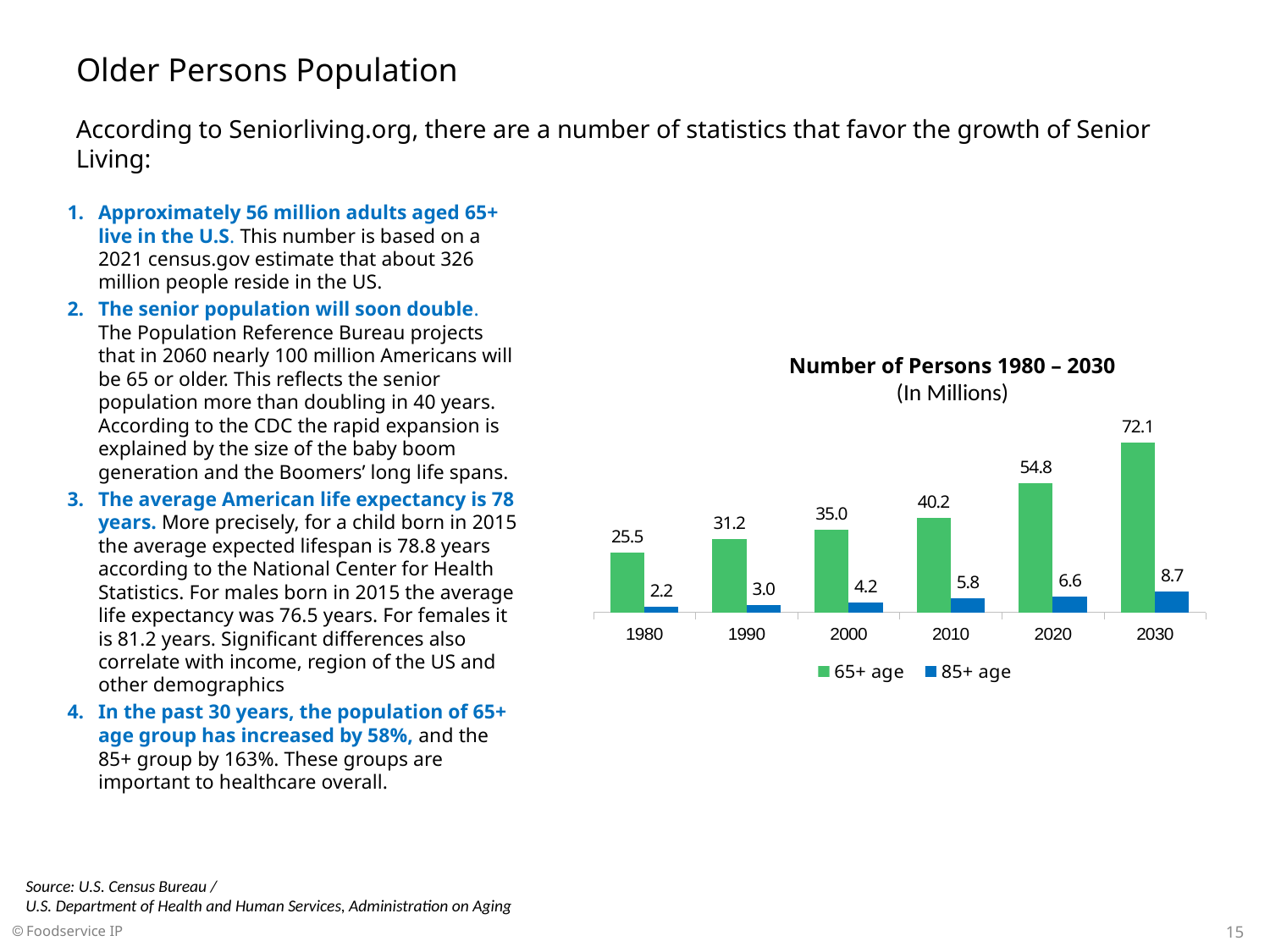
Do the 65+ age values rise or fall from 1980 to 2030? Rise What kind of chart is shown on the slide? Bar chart What is the title of the chart? Number of Persons 1980 – 2030 (In Millions) What is the value for the 85+ age series in 2010? 5.8 What is the value for the 65+ age series in 2000? 35.0 How many series does the chart legend list? 2 What is the difference between the 85+ age values for 2030 and 1980? 6.5 How many years are shown on the x axis of the chart? 6 Which year has the lowest value for the 85+ age series? 1980 Which is larger: the 65+ age value in 1990 or the 65+ age value in 2010? 2010 Which year has the highest value for the 65+ age series? 2030 What is the difference between the 65+ age values for 2030 and 2020? 17.3